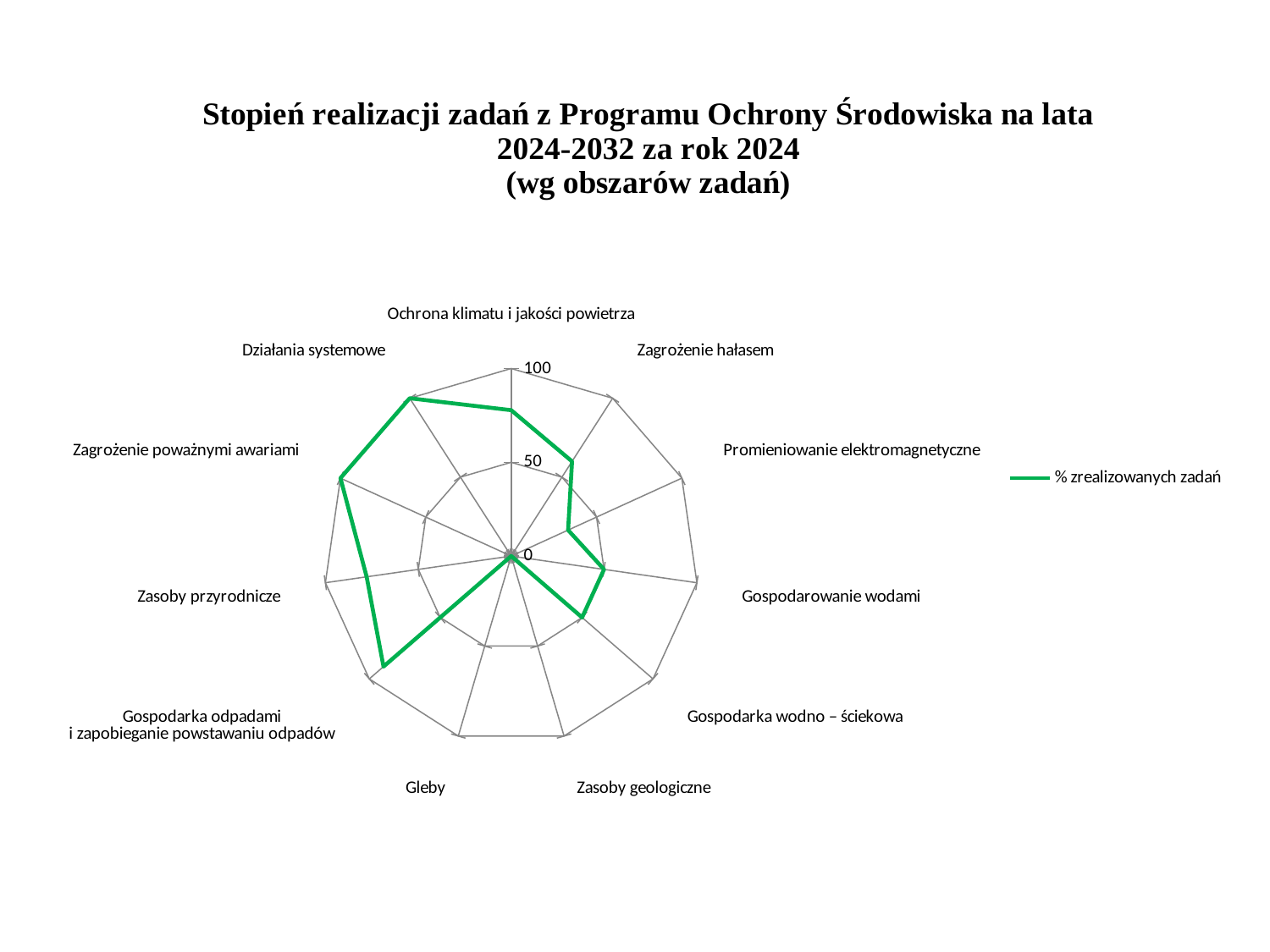
What kind of chart is shown on the slide? Radar chart What is the name of the series shown in the legend? % zrealizowanych zadań Which has the larger value: Gospodarka odpadami i zapobieganie powstawaniu odpadów or Promieniowanie elektromagnetyczne? Gospodarka odpadami i zapobieganie powstawaniu odpadów Is the value for Działania systemowe greater or less than 50? greater What is the highest value shown on the radial axis of the chart? 100 What is the value for Zasoby geologiczne? 0 How many categories (task areas) are plotted on the radar chart? 11 Is the value for Zasoby przyrodnicze greater or less than 50? greater Is the value for Ochrona klimatu i jakości powietrza greater or less than 50? greater How many series does the legend list? 1